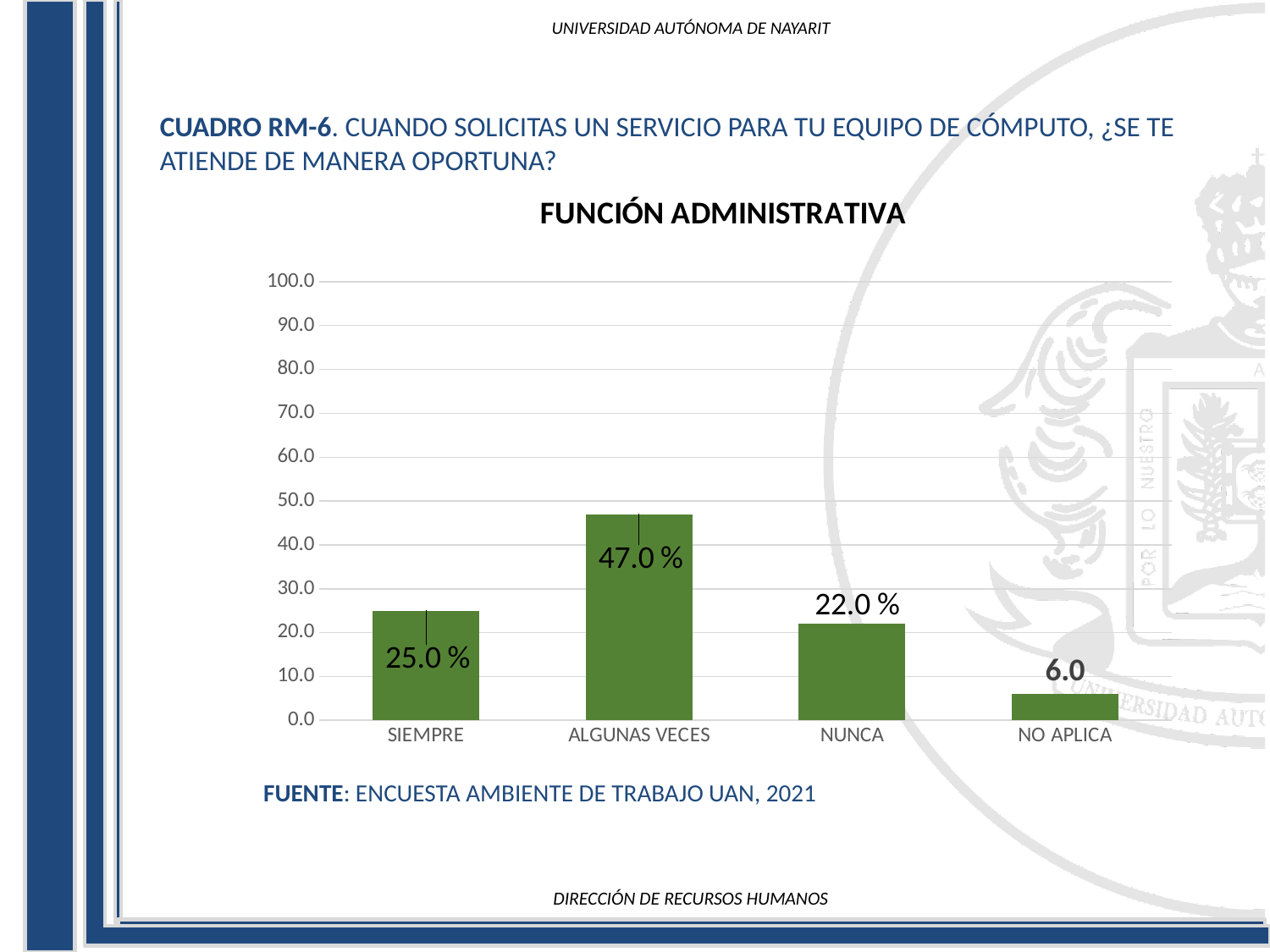
Which category has the highest value? ALGUNAS VECES What kind of chart is shown? bar chart What is the value for ALGUNAS VECES? 47.0 % How many categories are shown on the x axis? 4 Which category has the lowest value? NO APLICA What is the value shown for NO APLICA? 6.0 Is the value for ALGUNAS VECES greater or less than 50.0? less What is the value for SIEMPRE? 25.0 % Which is larger, the value for SIEMPRE or the value for NUNCA? SIEMPRE What is the difference between the values for ALGUNAS VECES and SIEMPRE? 22.0 % What is the title of the chart? FUNCIÓN ADMINISTRATIVA What is the value for NUNCA? 22.0 %